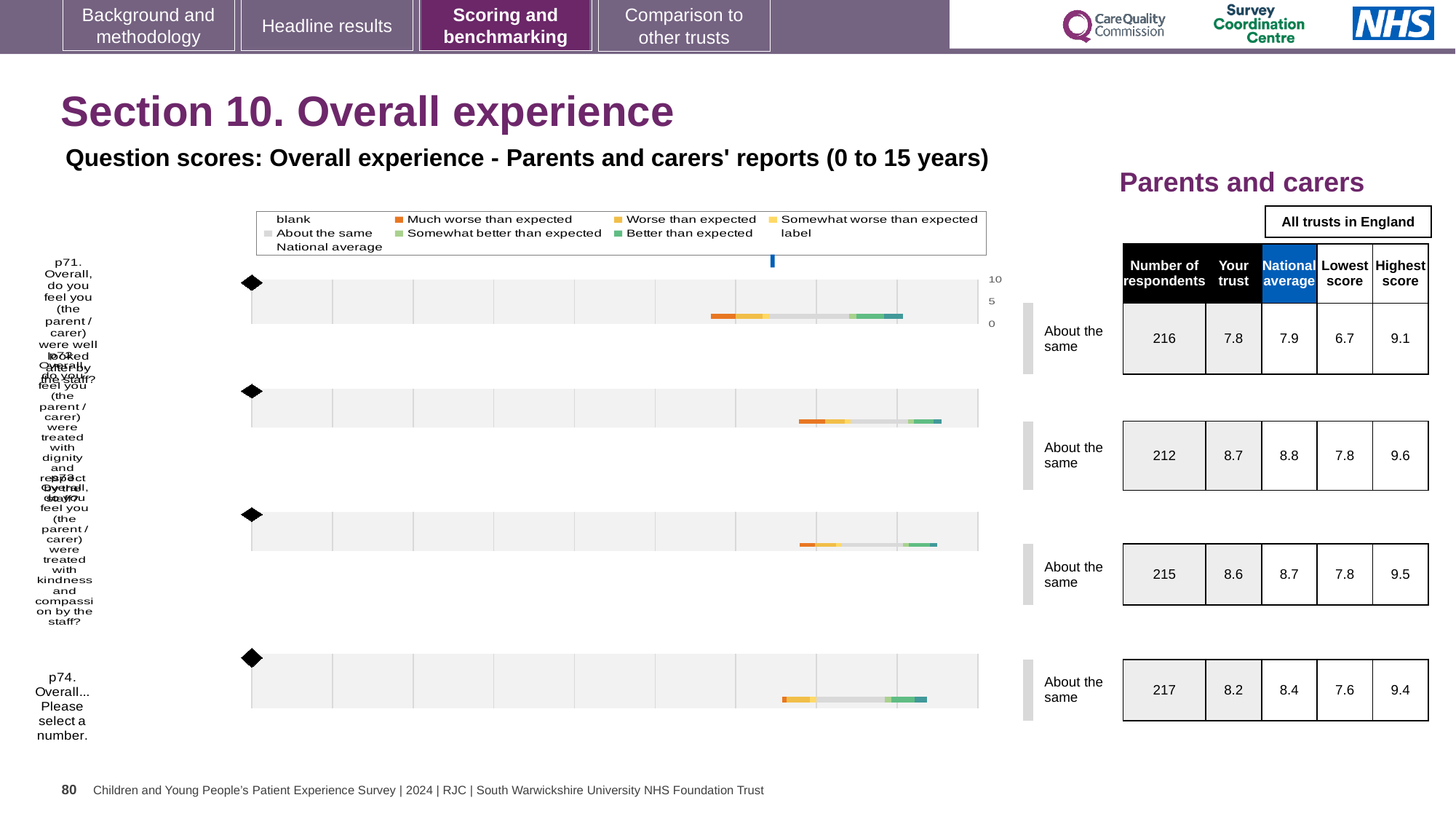
For p74, what is the difference between the national average (8.4) and the 'Your trust' score (8.2)? 0.2 In the legend of the Overall experience chart, what colour represents 'Much worse than expected'? orange What is the title printed above the Overall experience chart? Question scores: Overall experience - Parents and carers' reports (0 to 15 years) For p72, which is larger: the 'Your trust' score or the national average? National average Which question has the highest 'Your trust' score in the table beside the chart? p72 According to the table beside the chart, what is the national average for p71 (were well looked after by the staff)? 7.9 What kind of chart is used to show the question scores for Overall experience? bar chart How many entries does the legend of the Overall experience chart list? 9 Which question has the lowest 'Your trust' score in the table beside the chart? p71 According to the table beside the chart, what is the 'Your trust' score for p74 (Overall... Please select a number)? 8.2 How many questions (rows) are plotted in the Overall experience chart? 4 According to the table beside the chart, how many respondents answered p73 (treated with kindness and compassion)? 215